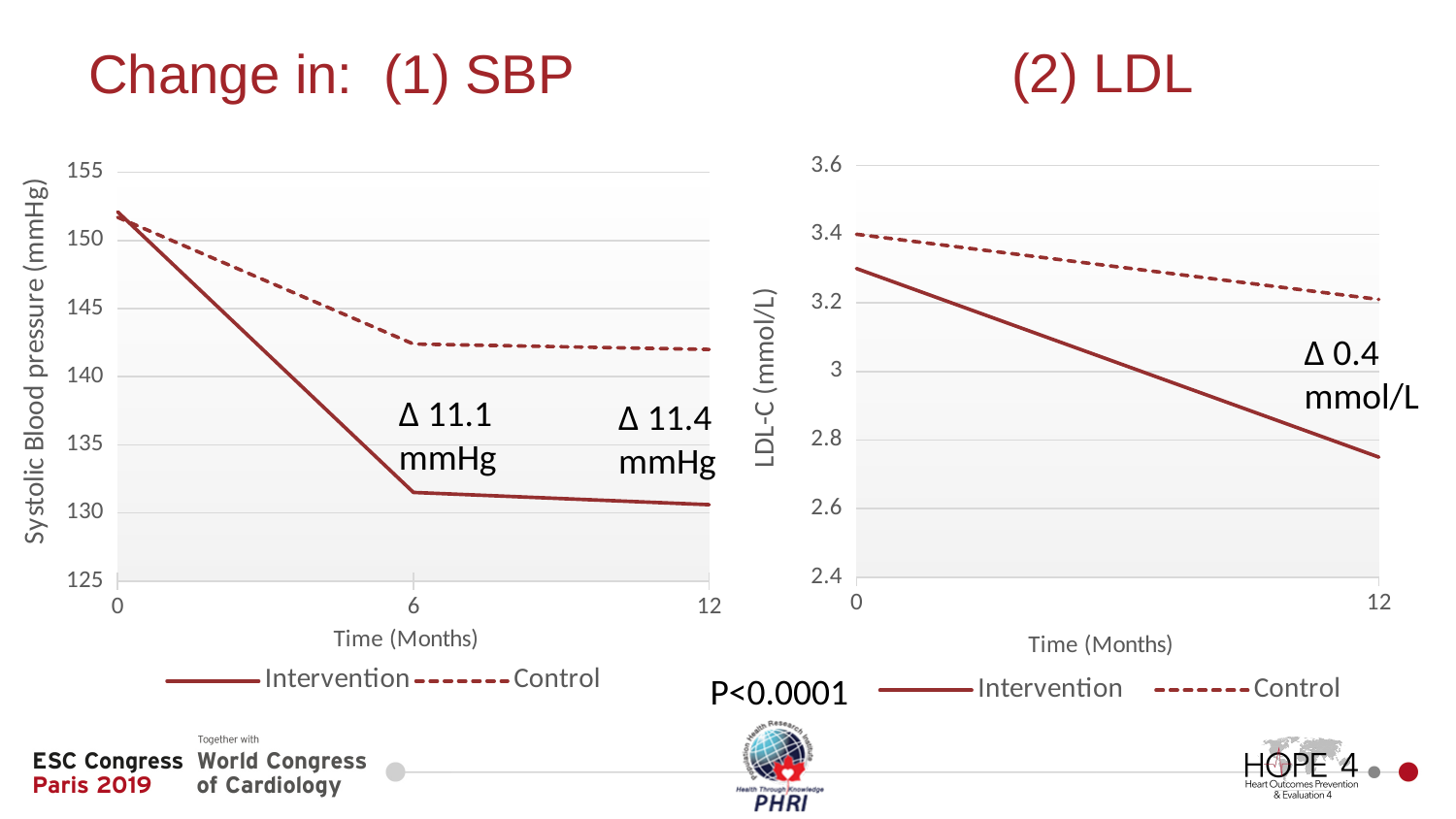
On the LDL chart, is the Control value at 12 months greater or less than 3? greater On the SBP chart, which series is higher at 6 months, Intervention or Control? Control On the SBP chart, is the Intervention value at 12 months greater or less than 135? less What kind of chart is the SBP chart on the left? Line chart How many time points are shown on the x axis of the SBP chart? 3 On the SBP chart, what difference is annotated at 12 months? Δ 11.4 mmHg On the SBP chart, is the Control value at 12 months greater or less than 140? greater What are the two series named in the legend of the LDL chart? Intervention and Control On the SBP chart, does the Intervention line rise or fall from 0 to 12 months? fall On the LDL chart, what difference between the groups is annotated? Δ 0.4 mmol/L How many series does the legend of the SBP chart list? 2